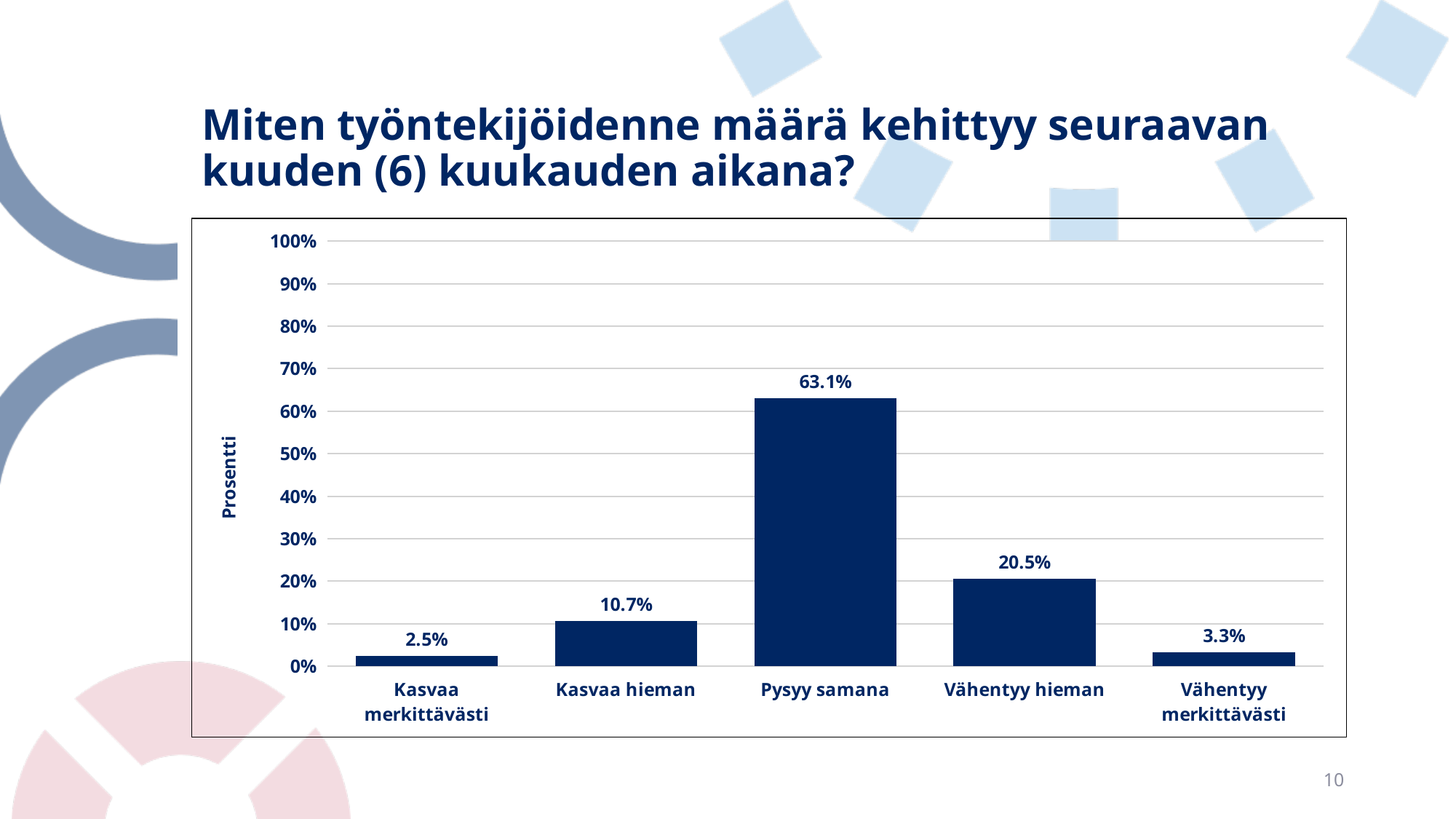
What is the label of the y axis? Prosentti Which category has the highest value? Pysyy samana What kind of chart is shown on the slide? bar chart Is the value for "Vähentyy hieman" greater or less than 30%? less What is the value for "Vähentyy merkittävästi"? 3.3% What is the value for "Pysyy samana"? 63.1% Which is larger, "Vähentyy merkittävästi" or "Kasvaa merkittävästi"? Vähentyy merkittävästi What is the difference between "Pysyy samana" and "Vähentyy hieman"? 42.6% What is the value for "Kasvaa hieman"? 10.7% What is the difference between "Vähentyy hieman" and "Kasvaa hieman"? 9.8% Which category has the lowest value? Kasvaa merkittävästi How many categories are shown on the x axis? 5